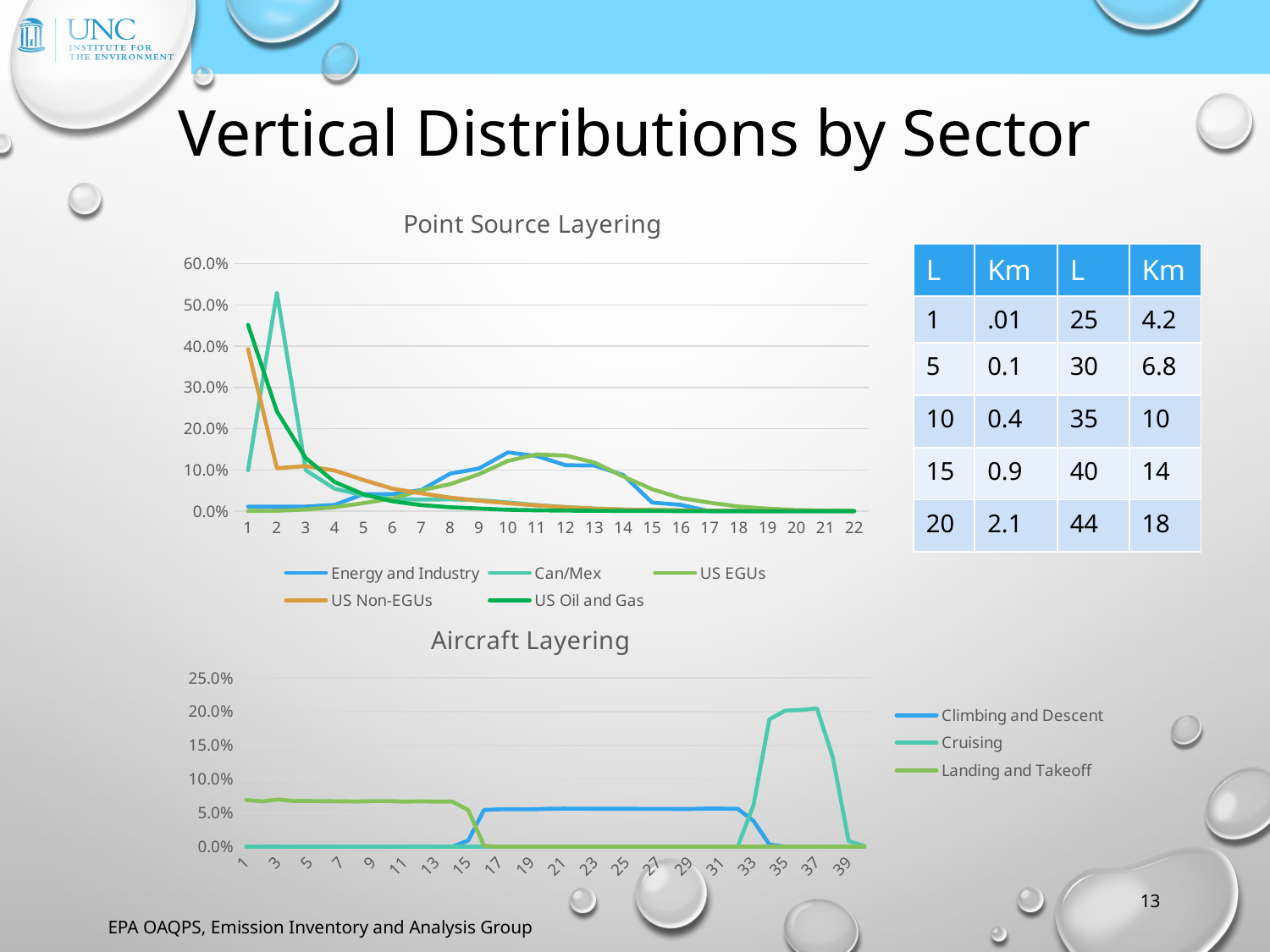
How many layers are shown on the x axis of the Point Source Layering chart? 22 What kind of chart is the Point Source Layering chart? Line chart How many series does the legend of the Point Source Layering chart list? 5 How many series does the legend of the Aircraft Layering chart list? 3 In the Point Source Layering chart, does the US Non-EGUs series rise or fall from layer 1 to layer 22? Fall In the Point Source Layering chart, is the value for Can/Mex at layer 2 greater or less than 40.0%? greater In the Point Source Layering chart, is the value for US Oil and Gas at layer 1 greater or less than 40.0%? greater In the Aircraft Layering chart, is the value for Landing and Takeoff at layer 1 greater or less than 10.0%? less In the Aircraft Layering chart, which series reaches the highest value? Cruising In the Point Source Layering chart, which series reaches the highest value? Can/Mex In the Point Source Layering chart, at layer 1, which is larger: Can/Mex or US Oil and Gas? US Oil and Gas